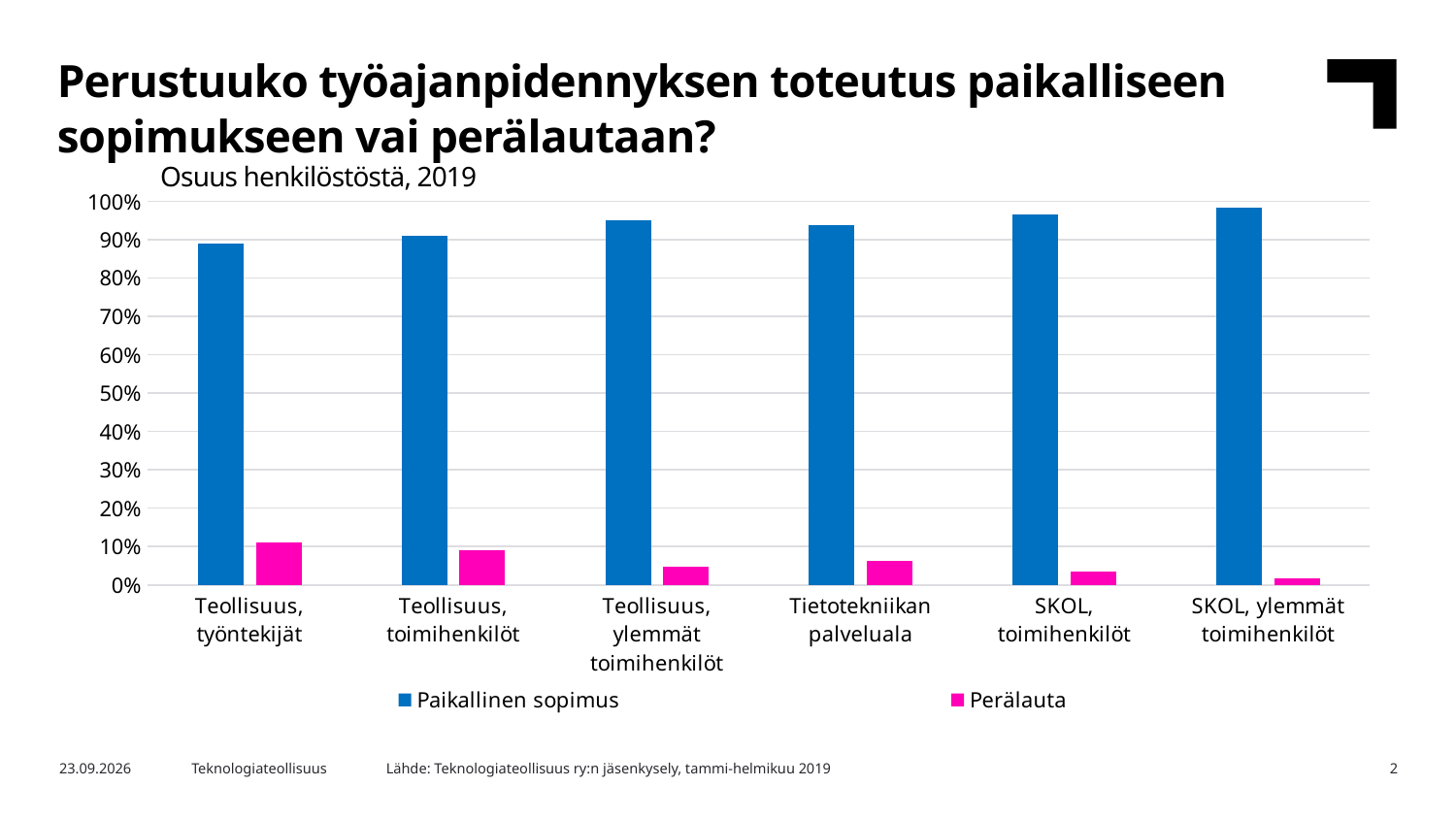
Which category has the lowest value for Perälauta? SKOL, ylemmät toimihenkilöt What kind of chart is shown on the slide? bar chart Which is larger for Teollisuus, työntekijät: Paikallinen sopimus or Perälauta? Paikallinen sopimus Is the Paikallinen sopimus value for SKOL, toimihenkilöt greater or less than 90%? greater How many series does the chart's legend list? 2 Is the Perälauta value for Tietotekniikan palveluala greater or less than 10%? less What are the two series named in the chart's legend? Paikallinen sopimus and Perälauta Which category has the lowest value for Paikallinen sopimus? Teollisuus, työntekijät Which category has the highest value for Perälauta? Teollisuus, työntekijät Is the Paikallinen sopimus value for Teollisuus, ylemmät toimihenkilöt greater or less than 90%? greater How many categories are shown on the x axis of the chart? 6 Which is larger for Perälauta: Teollisuus, työntekijät or SKOL, toimihenkilöt? Teollisuus, työntekijät